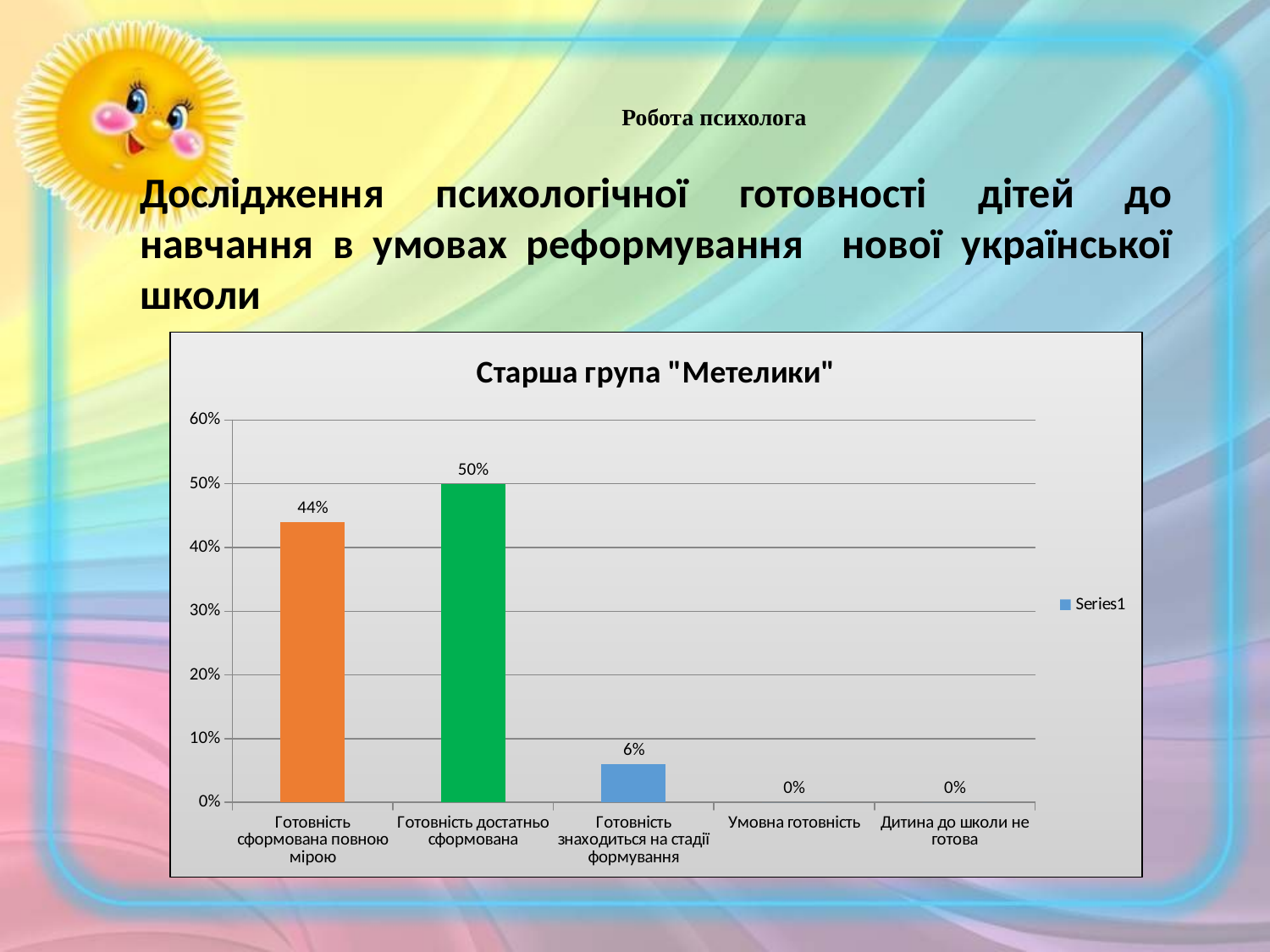
How many categories are shown on the x axis? 5 What is the value for "Готовність достатньо сформована"? 50% What is the value for "Готовність сформована повною мірою"? 44% How many series does the legend list? 1 Is the value for "Готовність сформована повною мірою" greater or less than 40%? greater What is the title of the chart? Старша група "Метелики" Which category has the highest value? Готовність достатньо сформована Which is larger: the value for "Готовність сформована повною мірою" or the value for "Готовність знаходиться на стадії формування"? Готовність сформована повною мірою What is the difference between the values for "Готовність достатньо сформована" and "Готовність сформована повною мірою"? 6% What is the value for "Умовна готовність"? 0% What kind of chart is shown on the slide? bar chart What is the value for "Готовність знаходиться на стадії формування"? 6%